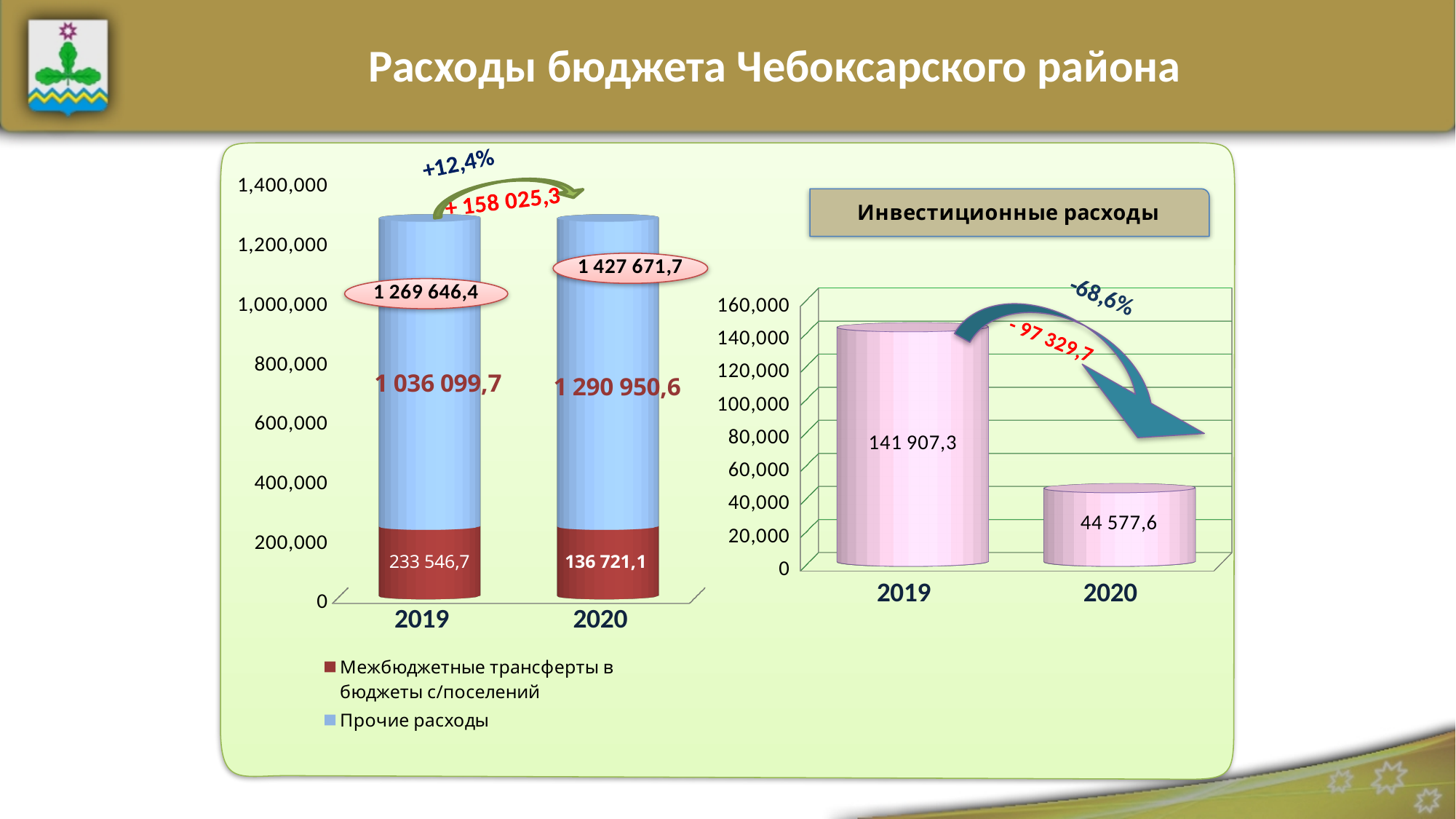
In the Инвестиционные расходы chart, which year has the lowest value? 2020 In the Инвестиционные расходы chart, what is the value for 2019? 141 907,3 In the left stacked bar chart, which year has the larger value for Межбюджетные трансферты в бюджеты с/поселений, 2019 or 2020? 2019 What kind of chart is the left chart on the slide? Stacked bar chart In the left stacked bar chart, what is the value of Межбюджетные трансферты в бюджеты с/поселений for 2019? 233 546,7 In the Инвестиционные расходы chart, is the value for 2020 greater or less than 60,000? less How many series does the legend of the left stacked bar chart list? 2 In the Инвестиционные расходы chart, what is the value for 2020? 44 577,6 In the left stacked bar chart, what is the total of the 2019 bar? 1 269 646,4 In the Инвестиционные расходы chart, do the values rise or fall from 2019 to 2020? Fall In the left stacked bar chart, what is the total of the 2020 bar? 1 427 671,7 In the left stacked bar chart, what is the value of Прочие расходы for 2020? 1 290 950,6